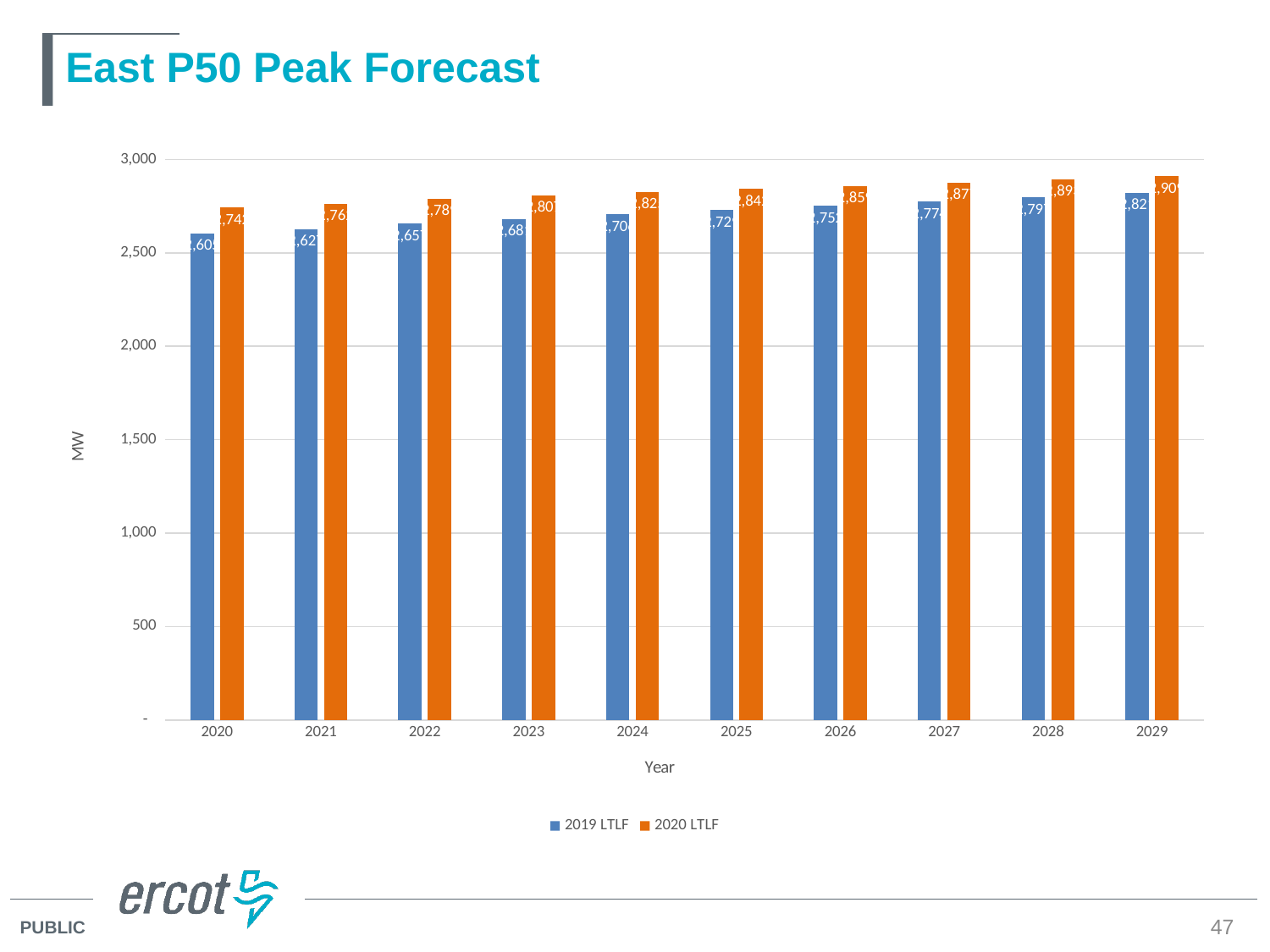
Do the 2019 LTLF values rise or fall from 2020 to 2029? rise Is the 2020 LTLF value for 2029 greater or less than 3,000? less What is the title of the chart? East P50 Peak Forecast How many years are shown on the x axis? 10 For 2025, which series has the larger value, 2019 LTLF or 2020 LTLF? 2020 LTLF Is the 2020 LTLF value for 2024 greater or less than 2,500? greater For 2020, which series has the larger value, 2019 LTLF or 2020 LTLF? 2020 LTLF Is the 2019 LTLF value for 2020 greater or less than 2,500? greater What unit is shown on the y axis? MW How many series does the legend list? 2 What kind of chart is shown on the slide? bar chart Do the 2020 LTLF values rise or fall from 2020 to 2029? rise